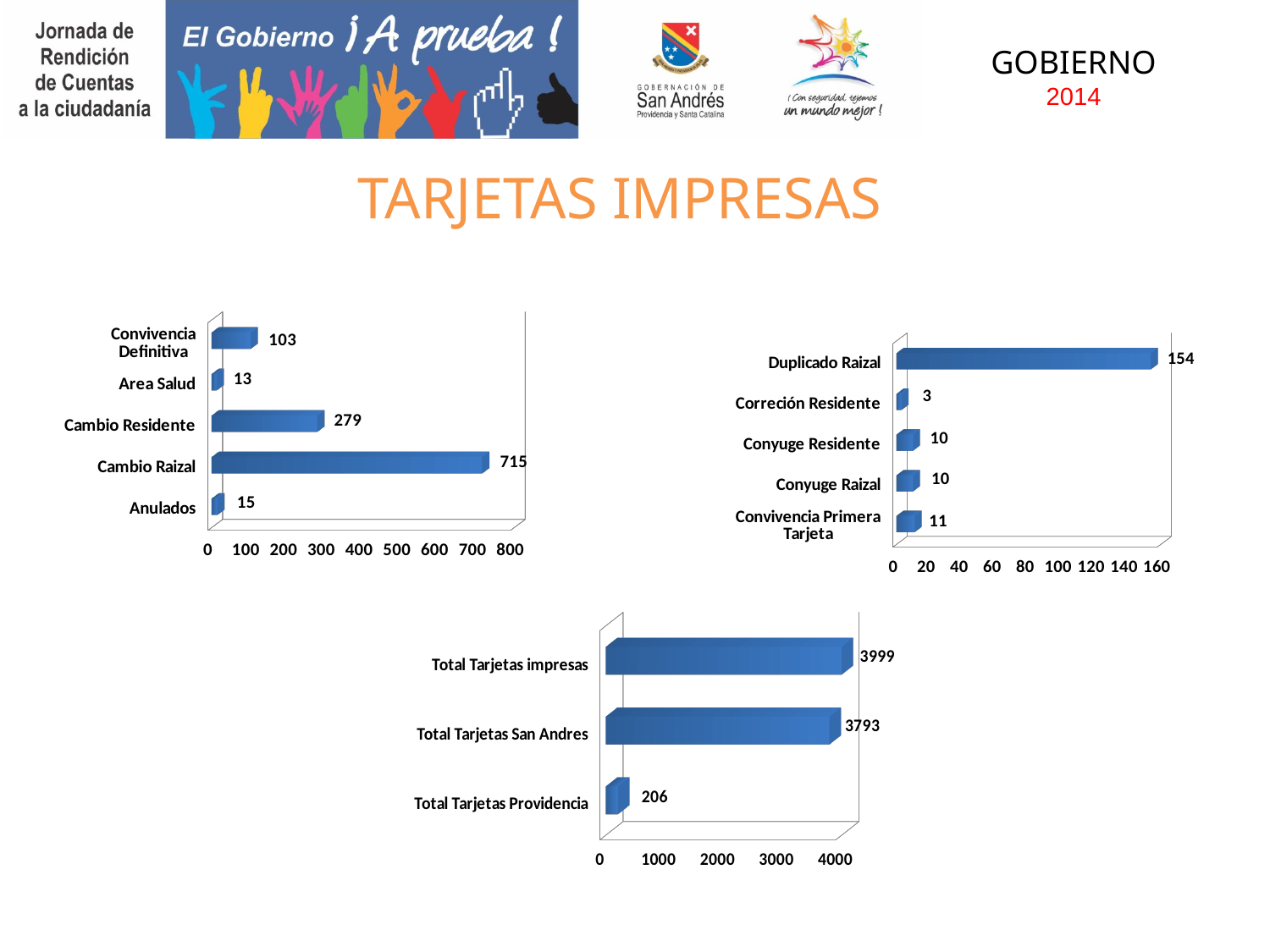
In the top-left chart, how many categories are shown? 5 In the top-right chart, what is the value for Convivencia Primera Tarjeta? 11 In the top-left chart, which category has the lowest value? Area Salud In the top-right chart, what is the value for Duplicado Raizal? 154 In the bottom chart, which is larger, Total Tarjetas San Andres or Total Tarjetas Providencia? Total Tarjetas San Andres In the top-right chart, how many categories are shown? 5 In the bottom chart, what is the difference between Total Tarjetas impresas and Total Tarjetas San Andres? 206 What kind of chart is the bottom chart? Bar chart In the bottom chart, what is the value for Total Tarjetas Providencia? 206 In the top-left chart, what is the difference between Cambio Raizal and Cambio Residente? 436 In the top-left chart, what is the value for Cambio Raizal? 715 In the top-right chart, which category has the lowest value? Correción Residente